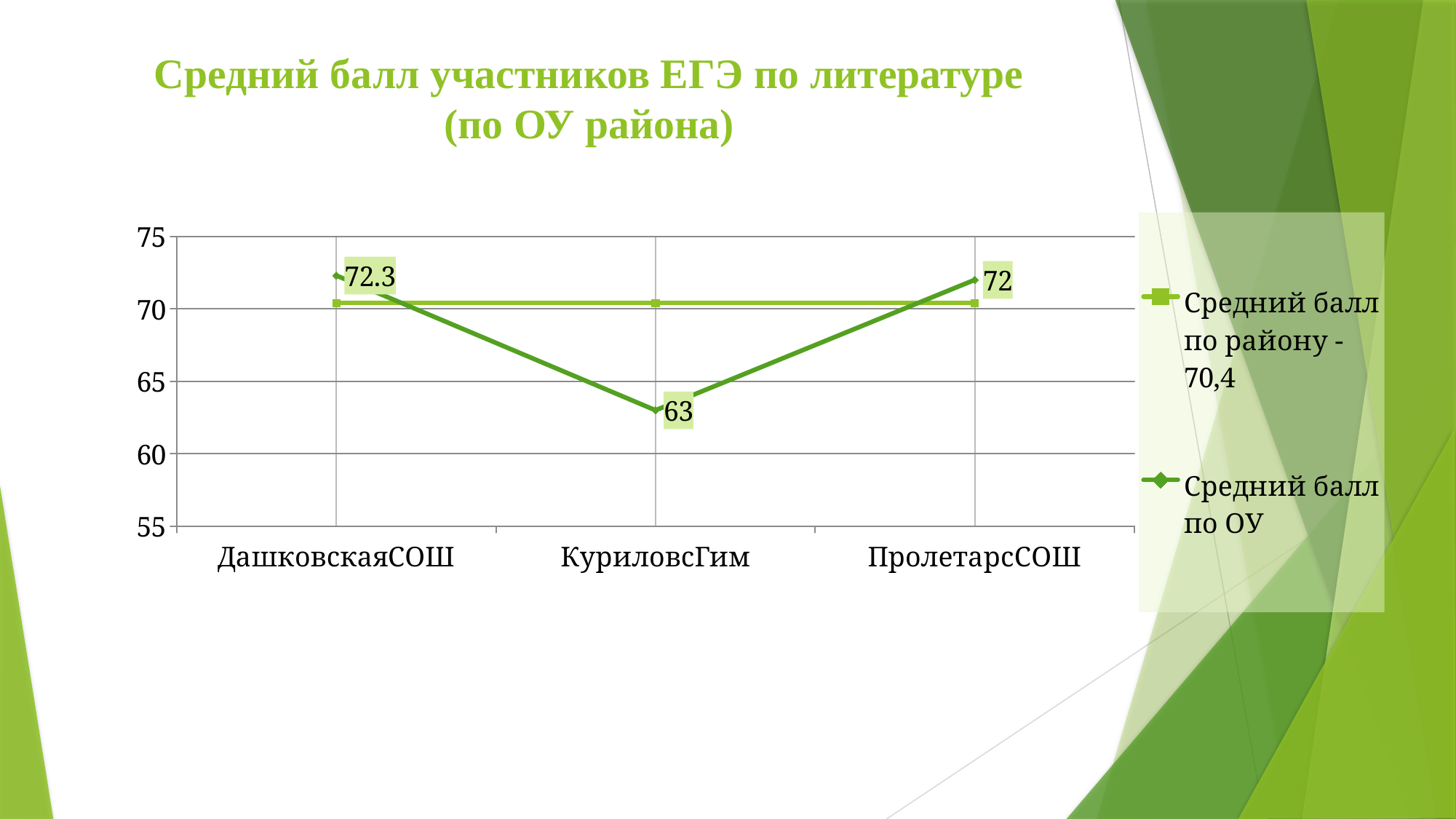
Is the average score for КуриловсГим greater or less than 65? less What is the average score (Средний балл по ОУ) for КуриловсГим? 63 What is the difference between the average scores of ДашковскаяСОШ and КуриловсГим? 9.3 What is the district average score (Средний балл по району) given in the legend? 70,4 What is the average score (Средний балл по ОУ) for ДашковскаяСОШ? 72.3 Which has a higher average score, ДашковскаяСОШ or КуриловсГим? ДашковскаяСОШ How many schools are shown on the x axis? 3 Which school has the lowest average score? КуриловсГим What kind of chart is shown on the slide? line chart How many series does the legend list? 2 What is the average score (Средний балл по ОУ) for ПролетарсСОШ? 72 What is the difference between the average scores of ПролетарсСОШ and КуриловсГим? 9